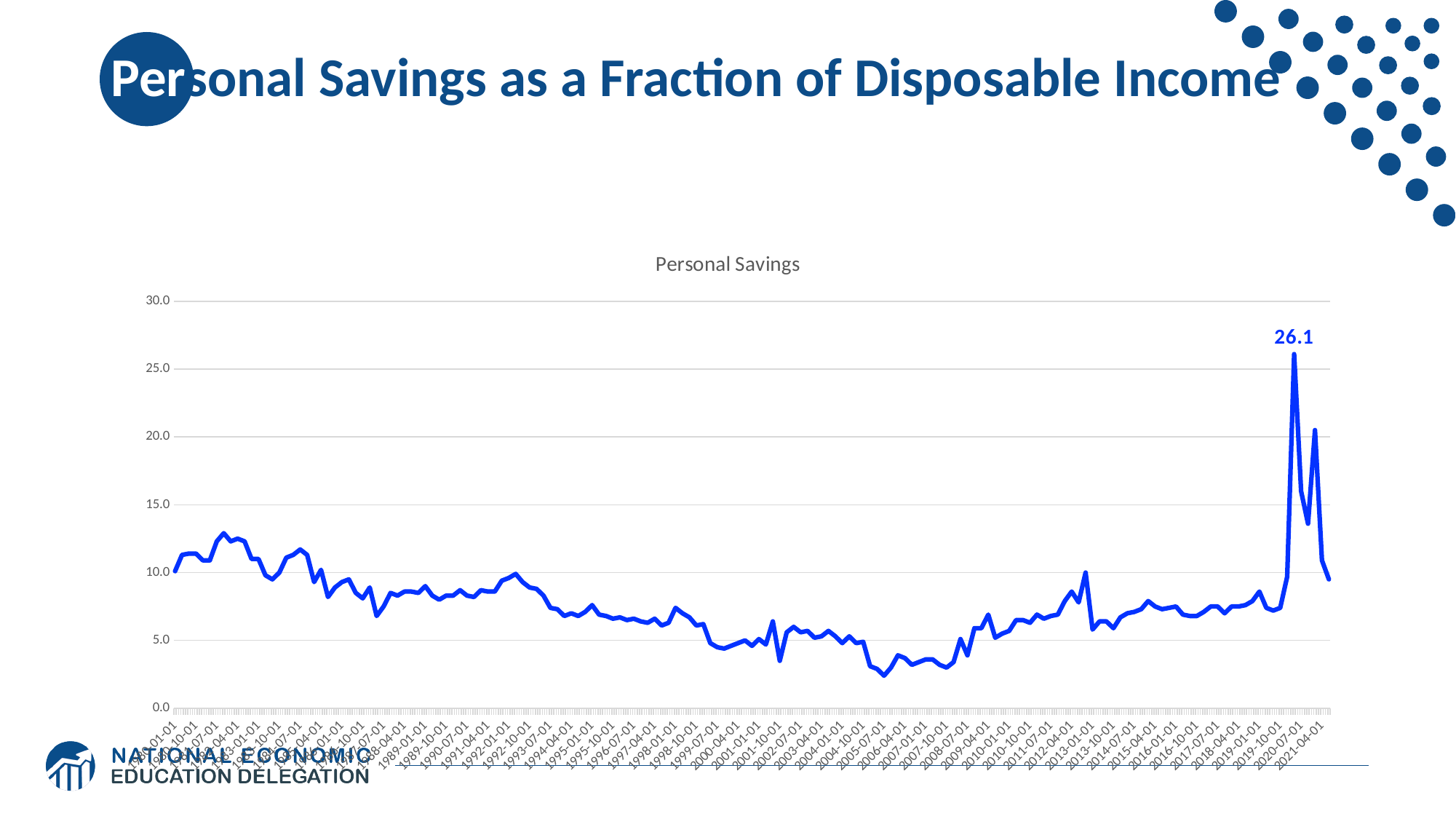
What is the title of the chart? Personal Savings What is the maximum value shown on the vertical axis? 30.0 Is the value for 1998-01-01 greater or less than 10.0? less How many data series are plotted on the chart? 1 What is the highest value reached by the Personal Savings line, as labeled on the chart? 26.1 Does the Personal Savings line generally rise or fall from 2005 to 2012? rise Is the value for 2005-07-01 greater or less than 5.0? less What kind of chart is shown on the slide? line chart Is the value for 2016-01-01 greater or less than 5.0? greater Does the Personal Savings line generally rise or fall from the early 1980s to 2005? fall